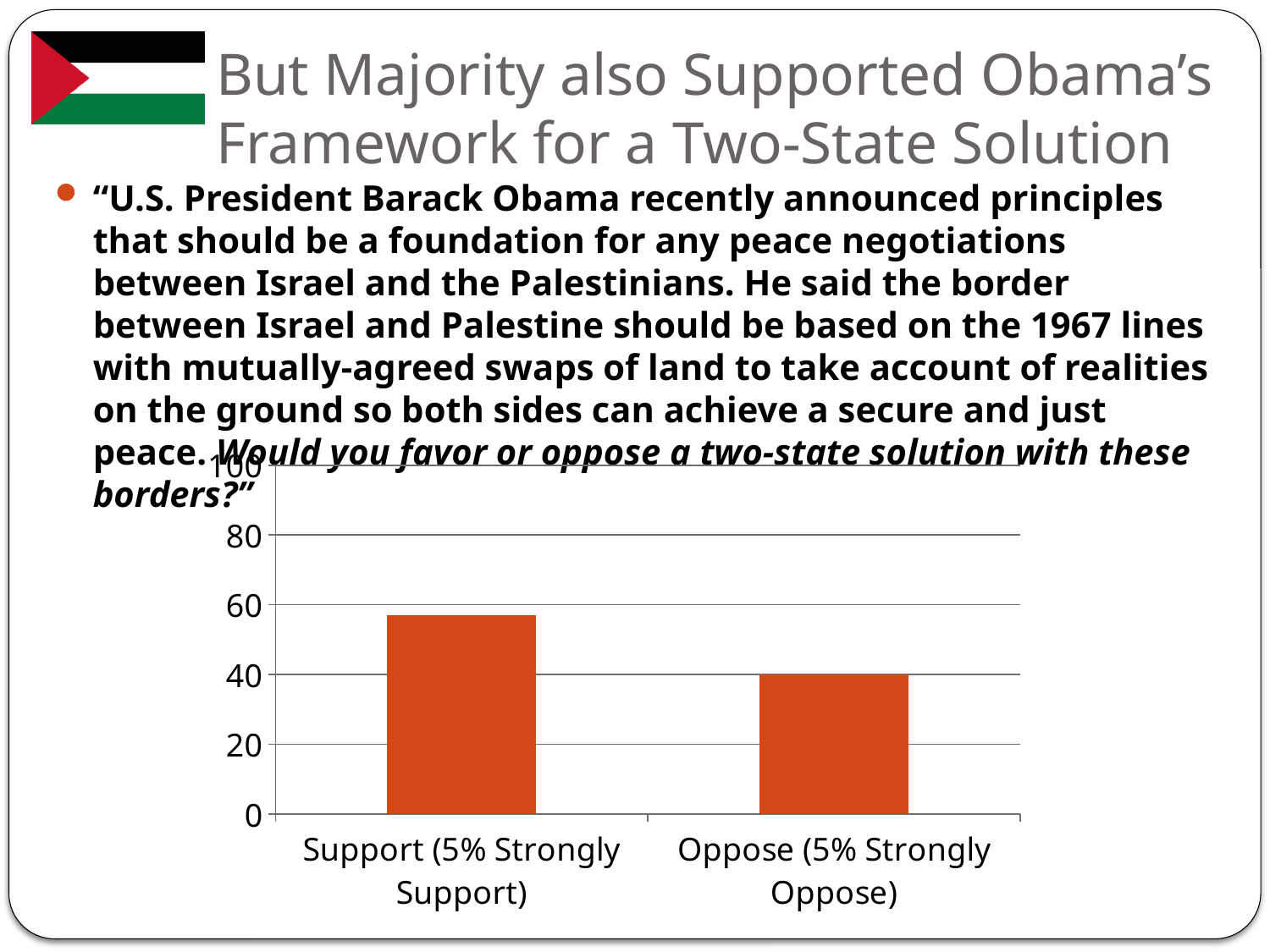
Is the value for Support (5% Strongly Support) greater or less than 60? less Which category has the highest bar in the chart? Support (5% Strongly Support) Which is larger, the value for Support (5% Strongly Support) or the value for Oppose (5% Strongly Oppose)? Support (5% Strongly Support) Is the value for Oppose (5% Strongly Oppose) greater or less than 20? greater How many categories are shown on the x axis of the chart? 2 Is the value for Support (5% Strongly Support) greater or less than 40? greater What kind of chart is shown on the slide? bar chart What colour are the bars in the chart? orange What is the highest value shown on the y axis of the chart? 100 Which category has the lowest bar in the chart? Oppose (5% Strongly Oppose)